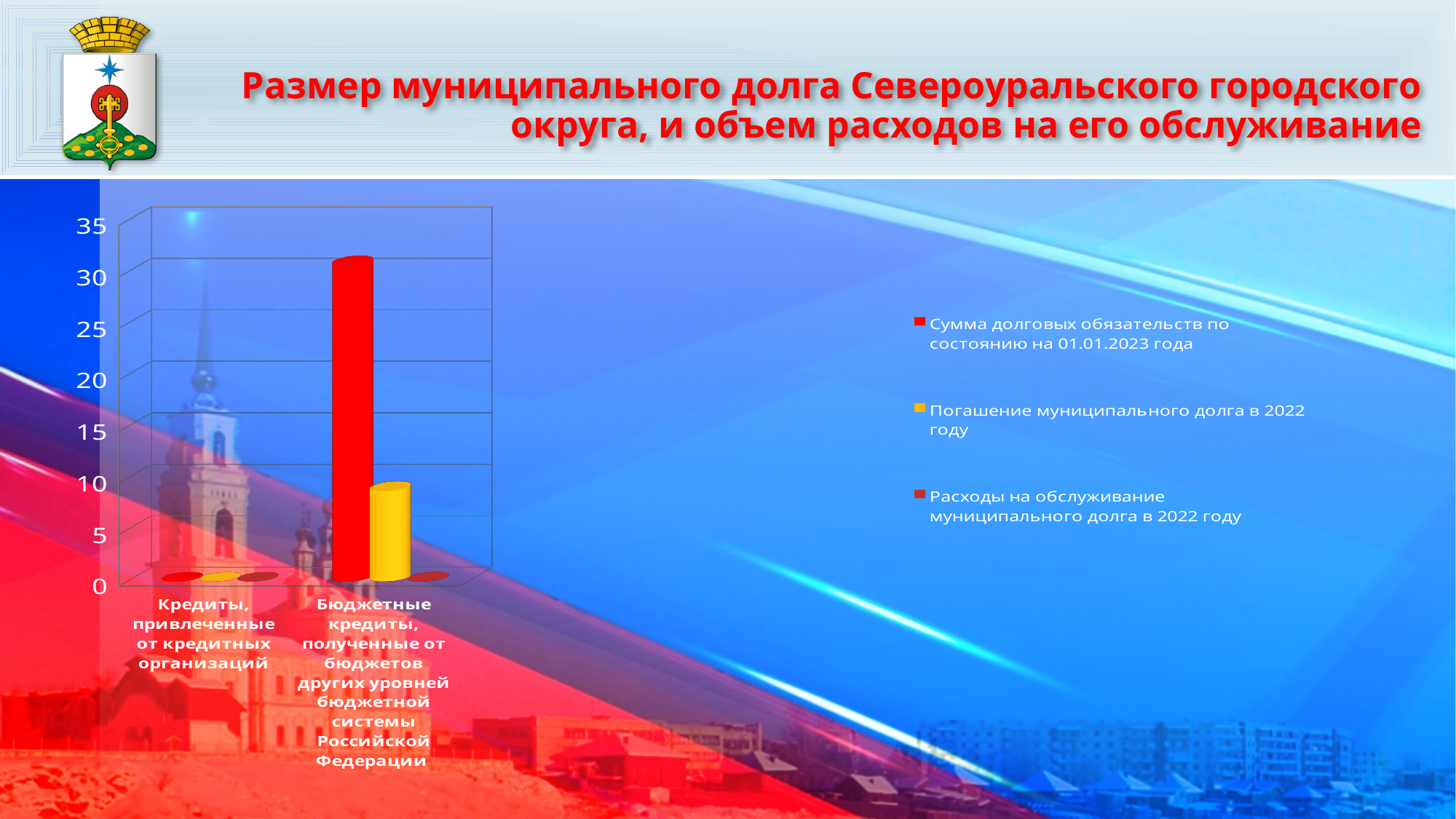
In the category "Бюджетные кредиты, полученные от бюджетов других уровней бюджетной системы Российской Федерации", which is larger: "Сумма долговых обязательств по состоянию на 01.01.2023 года" or "Погашение муниципального долга в 2022 году"? Сумма долговых обязательств по состоянию на 01.01.2023 года Is the value for "Сумма долговых обязательств по состоянию на 01.01.2023 года" in the category "Бюджетные кредиты, полученные от бюджетов других уровней бюджетной системы Российской Федерации" greater or less than 35? less What kind of chart is shown on the slide? bar chart What colour represents the series "Погашение муниципального долга в 2022 году" in the chart? yellow How many series does the chart legend list? 3 Which category has the higher value for "Сумма долговых обязательств по состоянию на 01.01.2023 года"? Бюджетные кредиты, полученные от бюджетов других уровней бюджетной системы Российской Федерации What is the highest value shown on the chart's vertical axis? 35 Is the value for "Сумма долговых обязательств по состоянию на 01.01.2023 года" in the category "Бюджетные кредиты, полученные от бюджетов других уровней бюджетной системы Российской Федерации" greater or less than 30? greater Is the value for "Сумма долговых обязательств по состоянию на 01.01.2023 года" in the category "Кредиты, привлеченные от кредитных организаций" greater or less than 5? less How many categories are shown on the x axis of the chart? 2